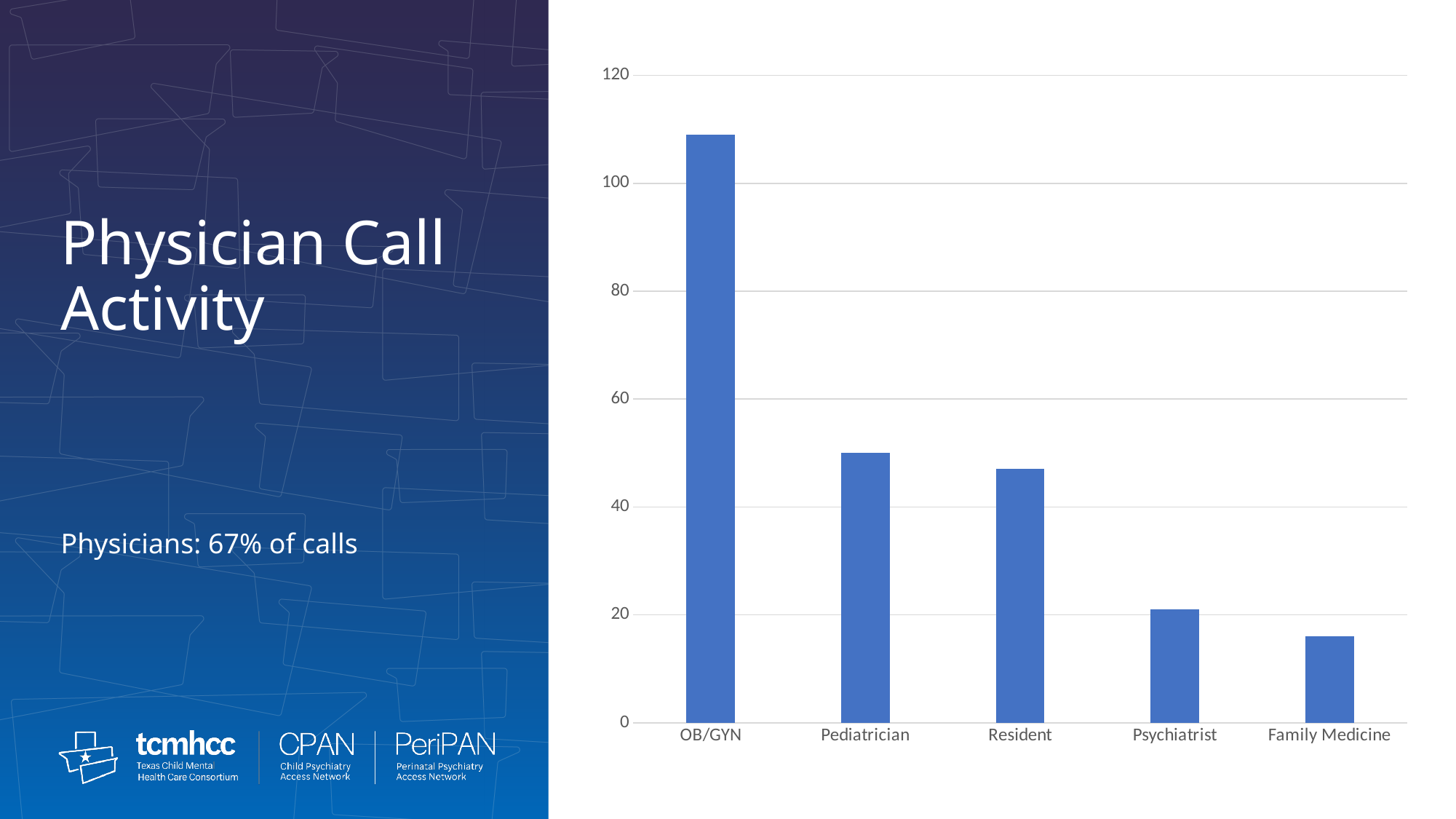
What kind of chart is shown on the slide? bar chart Which category has the highest bar in the chart? OB/GYN Is the value for Pediatrician greater or less than 40? greater What is the highest value shown on the y axis of the chart? 120 How many categories are shown on the x axis of the chart? 5 Is the value for OB/GYN greater or less than 100? greater Do the bar values rise or fall moving from left to right along the x axis? fall Is the value for Resident greater or less than 60? less Which is larger, the value for OB/GYN or the value for Pediatrician? OB/GYN Which category has the lowest bar in the chart? Family Medicine Which is larger, the value for Psychiatrist or the value for Family Medicine? Psychiatrist